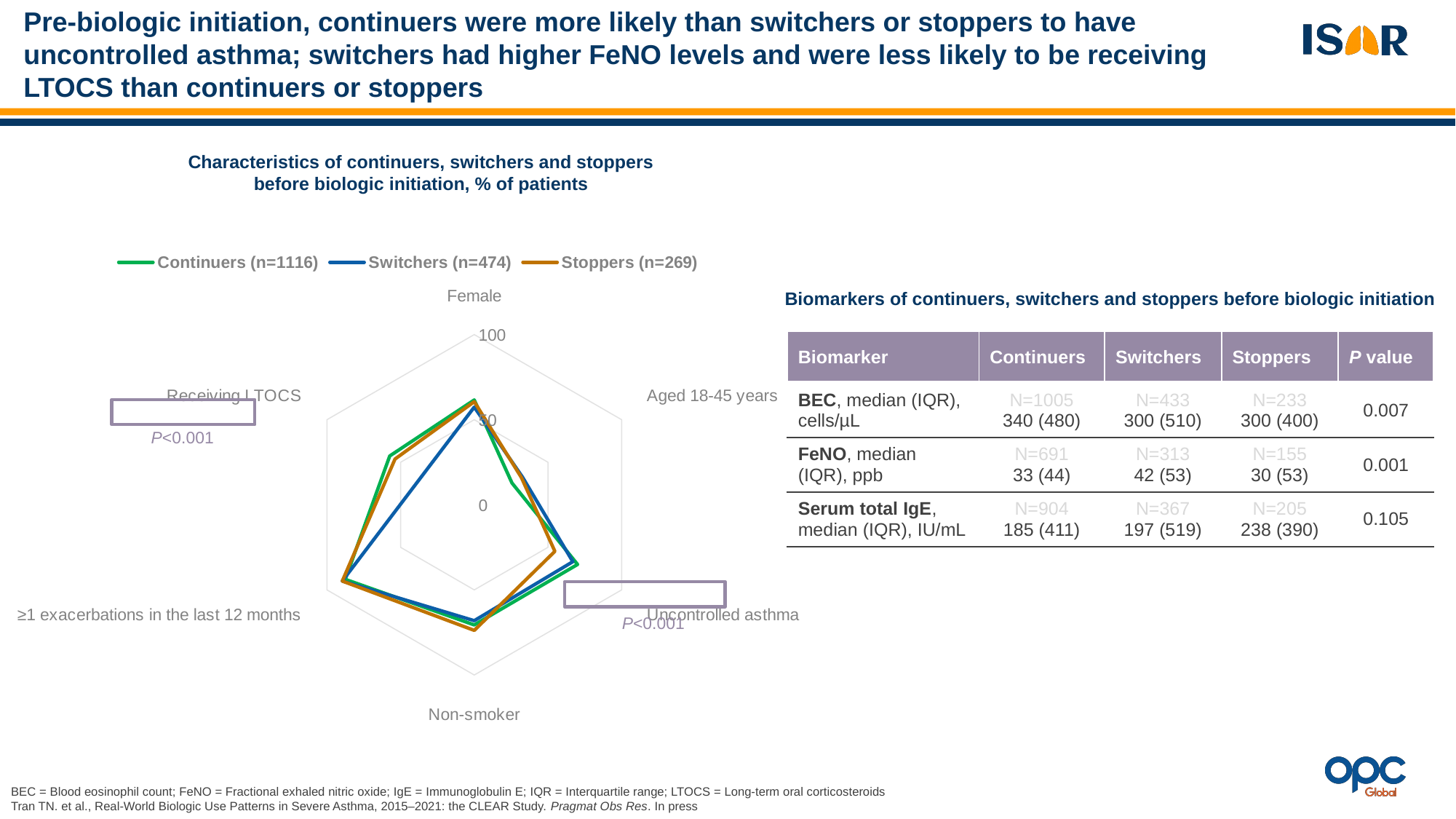
In the radar chart, is the value for Uncontrolled asthma for Continuers greater or less than 50? greater In the radar chart, which series has the larger value for Uncontrolled asthma: Switchers or Stoppers? Switchers In the radar chart, which series has the larger value for Uncontrolled asthma: Continuers or Stoppers? Continuers In the radar chart, is the value for Non-smoker for Continuers greater or less than 50? greater What kind of chart is shown on the slide? Radar chart Which colour represents Switchers (n=474) in the radar chart? Blue How many series does the legend of the radar chart list? 3 How many categories (axes) does the radar chart have? 6 In the radar chart, is the value for ≥1 exacerbations in the last 12 months for Stoppers greater or less than 50? greater What is the title of the radar chart? Characteristics of continuers, switchers and stoppers before biologic initiation, % of patients In the radar chart, which series has the larger value for Receiving LTOCS: Continuers or Switchers? Continuers